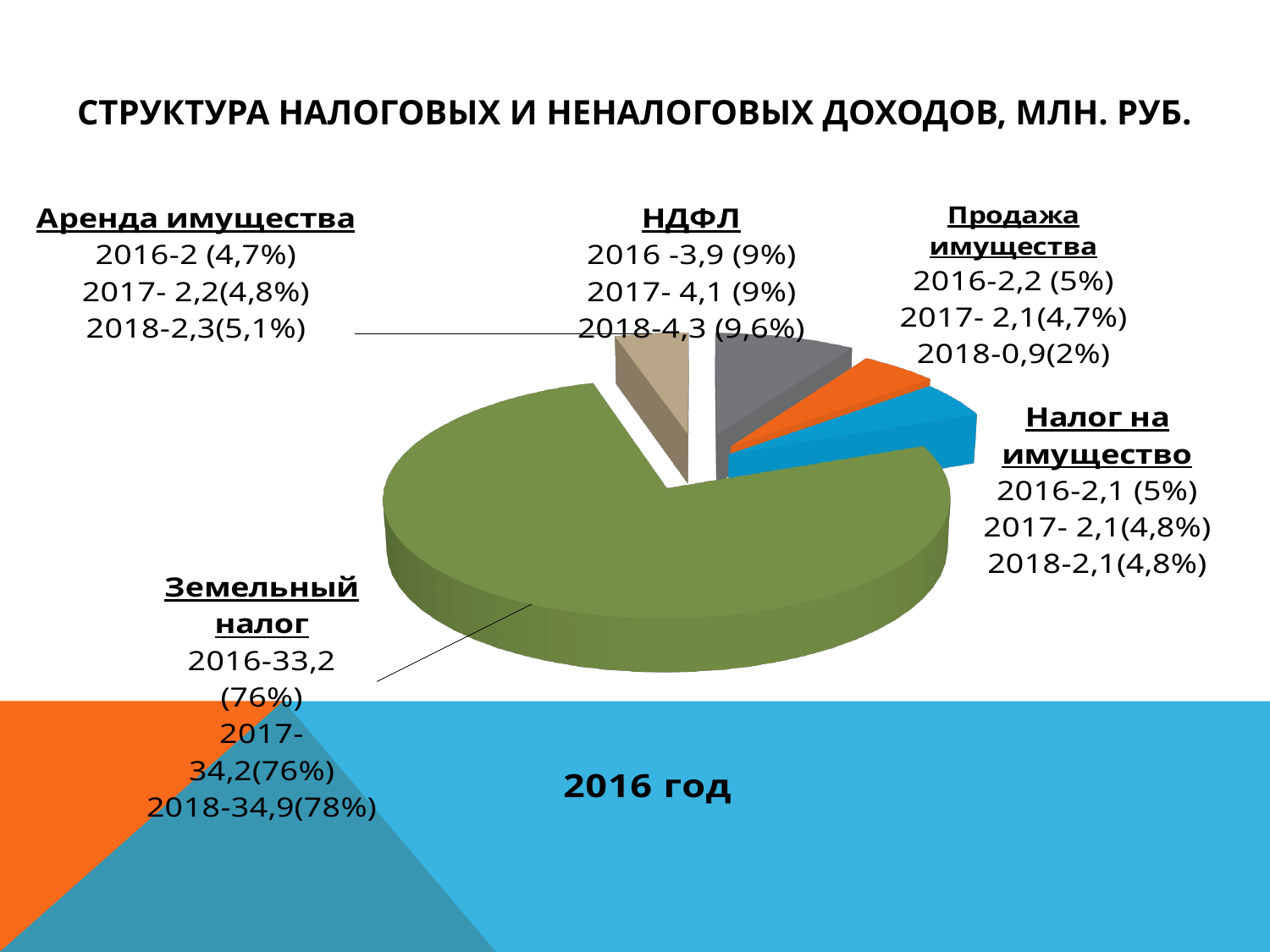
What is the value of НДФЛ for 2016? 3,9 What is the value of Аренда имущества for 2018? 2,3 What share does Налог на имущество have in 2017? 4,8% Which category has the largest slice of the pie? Земельный налог What kind of chart is shown on the slide? Pie chart What is the value of Земельный налог for 2016? 33,2 What share of the pie does Земельный налог have in 2016? 76% How many slices does the pie chart have? 5 What is the difference between Земельный налог and НДФЛ in 2016? 29,3 Which is larger in 2016, НДФЛ or Продажа имущества? НДФЛ Which category has the smallest value in 2016? Аренда имущества Which year does the pie chart represent? 2016 год